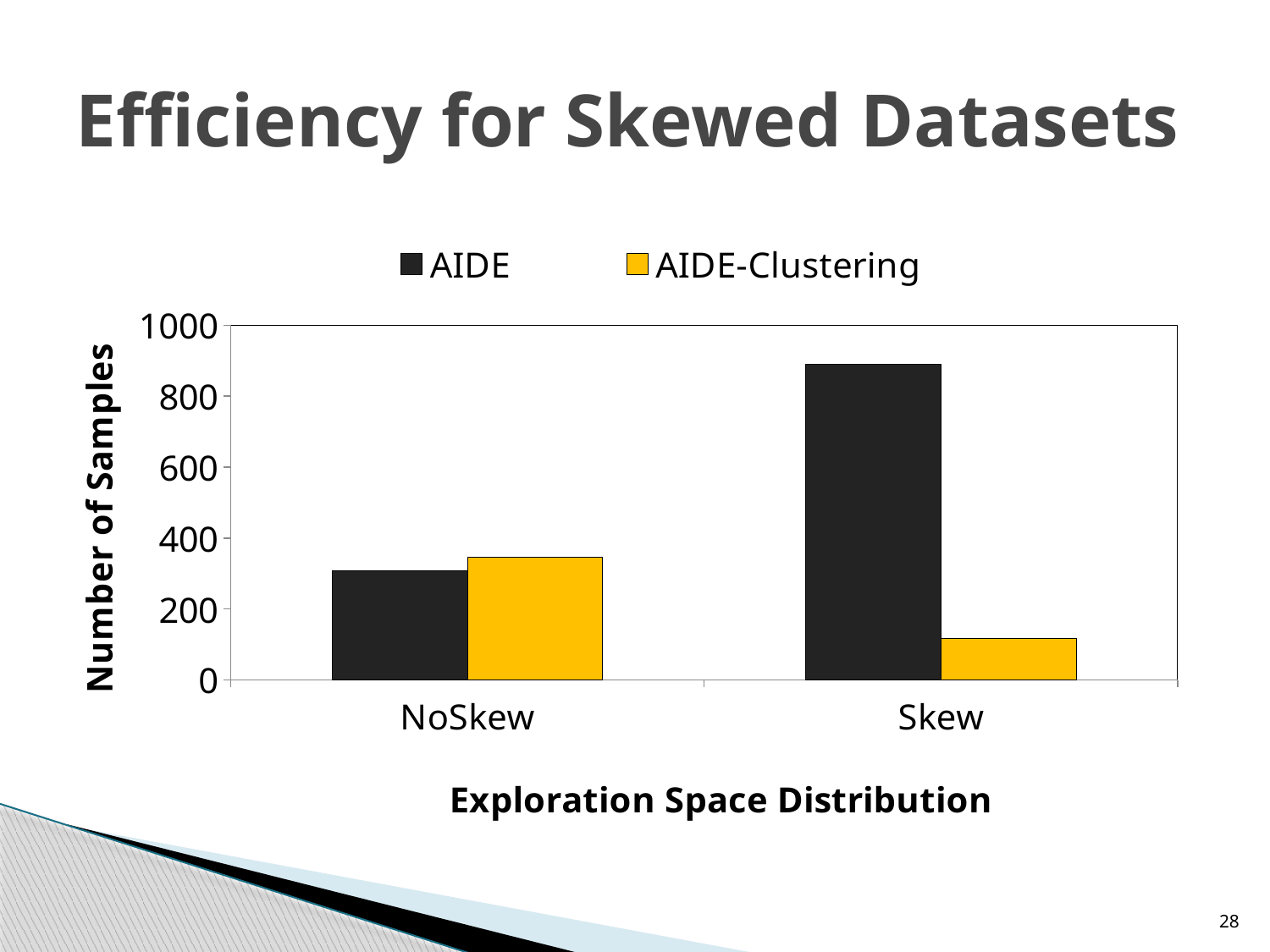
Which bar is the shortest in the chart? AIDE-Clustering in Skew Is the value for AIDE in the NoSkew category greater or less than 400? less How many series does the legend list? 2 Is the value for AIDE-Clustering in the NoSkew category greater or less than 200? greater Which series is shown in yellow in the legend? AIDE-Clustering In the Skew category, which series has the larger value, AIDE or AIDE-Clustering? AIDE Is the value for AIDE-Clustering in the Skew category greater or less than 200? less What kind of chart is shown on the slide? bar chart Which bar is the tallest in the chart? AIDE in Skew How many categories are shown on the x axis? 2 What is the label of the y axis? Number of Samples